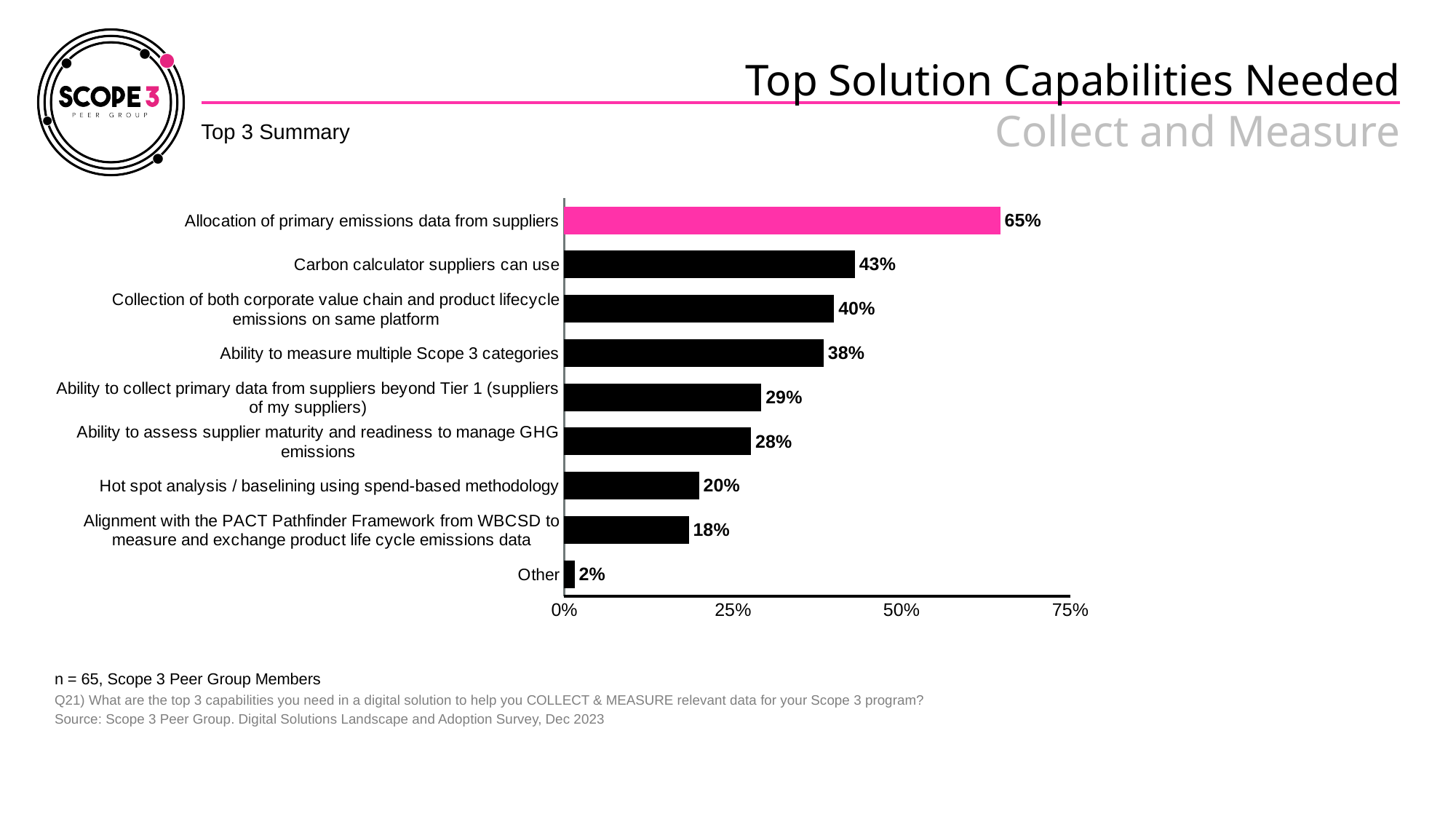
What is the value for "Allocation of primary emissions data from suppliers"? 65% What is the value for "Carbon calculator suppliers can use"? 43% What is the difference between "Ability to measure multiple Scope 3 categories" and "Other"? 36% Which category has the lowest value? Other Which is larger: "Ability to measure multiple Scope 3 categories" or "Hot spot analysis / baselining using spend-based methodology"? Ability to measure multiple Scope 3 categories Is the value for "Allocation of primary emissions data from suppliers" greater or less than 50%? greater Which category has the highest value? Allocation of primary emissions data from suppliers How many categories are shown in the chart? 9 What is the value for "Hot spot analysis / baselining using spend-based methodology"? 20% Which bar is coloured pink rather than black? Allocation of primary emissions data from suppliers What kind of chart is shown on the slide? Bar chart What is the difference between "Allocation of primary emissions data from suppliers" and "Carbon calculator suppliers can use"? 22%